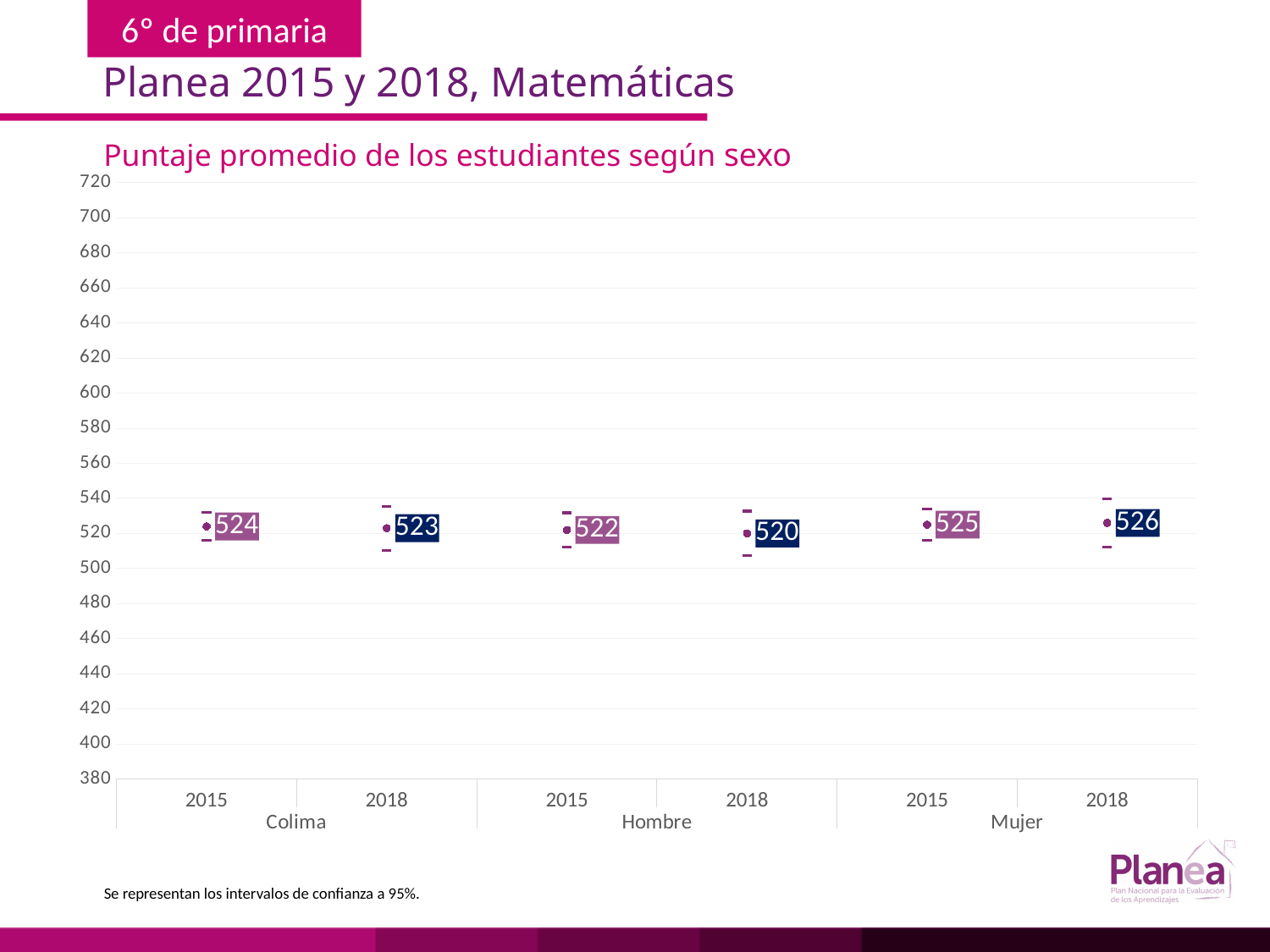
What is the title of the chart? Puntaje promedio de los estudiantes según sexo Which group and year has the lowest average score? Hombre 2018 What is the average score for Mujer in 2015? 525 Did the Hombre score rise or fall from 2015 to 2018? fall What is the difference between the Colima 2015 score and the Colima 2018 score? 1 What is the average score for Colima in 2015? 524 Which group and year has the highest average score? Mujer 2018 What is the average score for Hombre in 2018? 520 What is the average score for Mujer in 2018? 526 What is the difference between the Mujer 2018 score and the Hombre 2018 score? 6 Which is larger, the Hombre 2015 score or the Mujer 2015 score? Mujer 2015 How many data points are plotted on the chart? 6